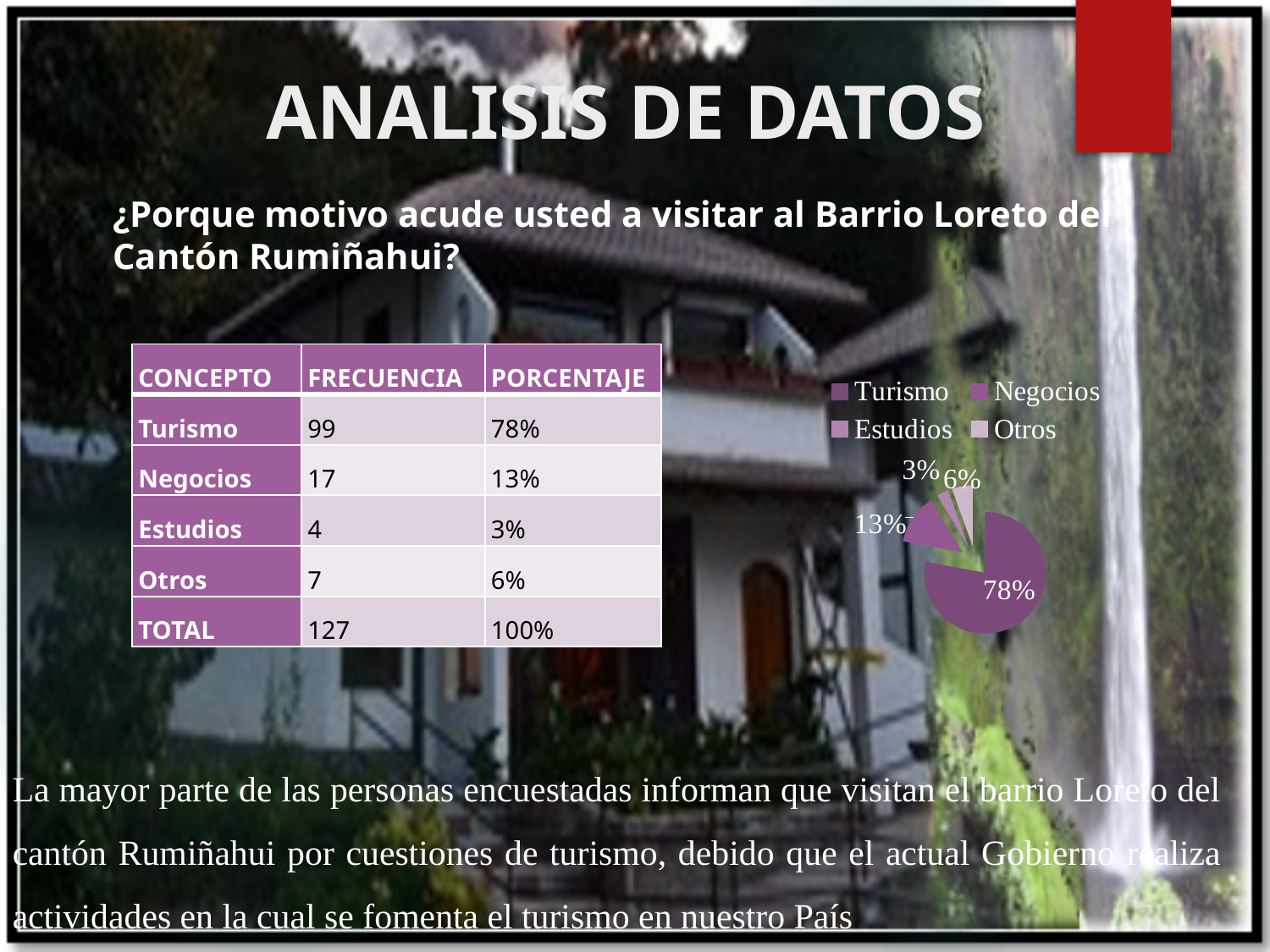
Which slice is larger, Negocios or Otros? Negocios What share of the pie does Estudios represent? 3% What is the difference in percentage points between the Otros slice and the Estudios slice? 3% Which category has the smallest slice of the pie? Estudios Which category has the largest slice of the pie? Turismo What share of the pie does Turismo represent? 78% How many categories does the legend of the pie chart list? 4 What kind of chart is shown on the slide? pie chart What share of the pie does Negocios represent? 13% What is the difference in percentage points between the Turismo slice and the Negocios slice? 65% Which legend entry appears first in the pie chart's legend? Turismo